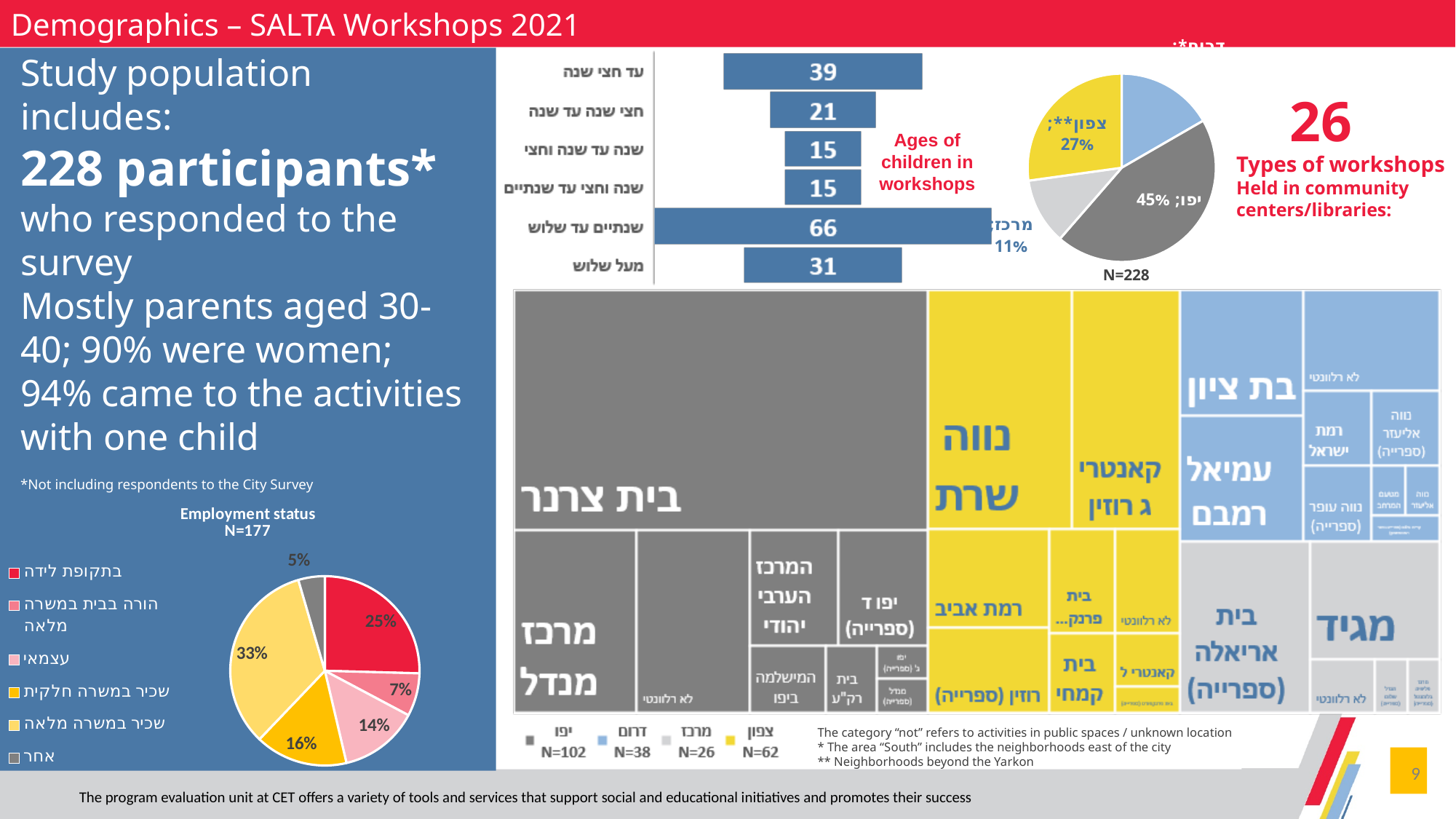
In the 'Ages of children in workshops' bar chart, what is the value for שנתיים עד שלוש? 66 In the 'Ages of children in workshops' bar chart, which is larger: the value for חצי שנה עד שנה or the value for מעל שלוש? מעל שלוש In the regions pie chart (N=228) at the top right, what share is יפו? 45% What is the N shown under the 'Employment status' pie chart title? N=177 In the 'Ages of children in workshops' bar chart, what is the difference between the values for שנתיים עד שלוש and מעל שלוש? 35 In the regions pie chart (N=228) at the top right, what share is צפון? 27% In the 'Employment status' pie chart, which category has the smallest share? אחר In the 'Ages of children in workshops' bar chart, which age category has the highest value? שנתיים עד שלוש In the 'Employment status' pie chart, what share is שכיר במשרה מלאה? 33% In the 'Ages of children in workshops' bar chart, what is the value for עד חצי שנה? 39 What kind of chart is the 'Ages of children in workshops' chart? Bar chart In the 'Ages of children in workshops' bar chart, how many age categories are shown? 6